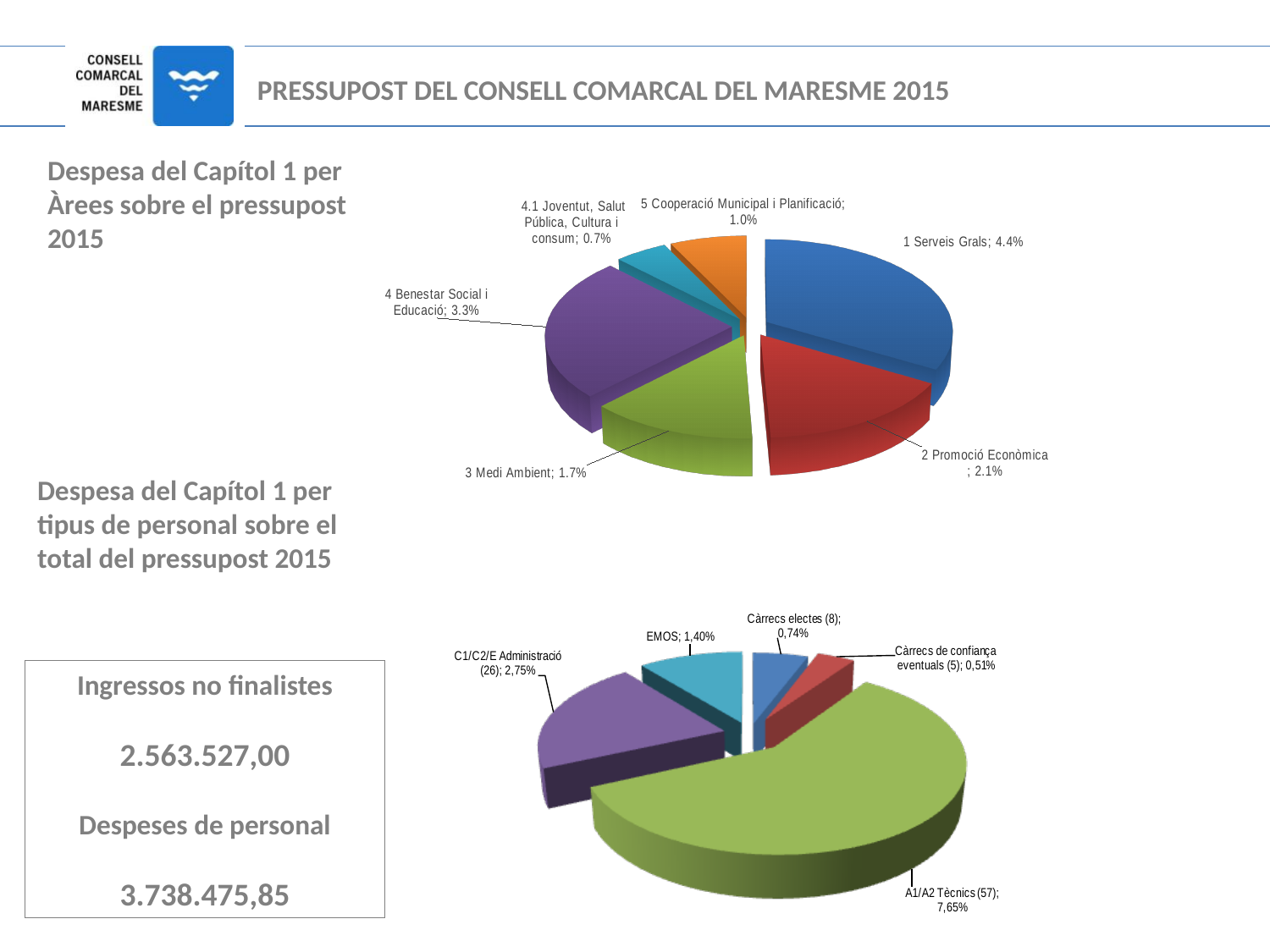
In the bottom pie chart (Despesa del Capítol 1 per tipus de personal), what is the value for A1/A2 Tècnics (57)? 7,65% In the top pie chart (Despesa del Capítol 1 per Àrees), which area has the smallest slice? 4.1 Joventut, Salut Pública, Cultura i consum In the top pie chart (Despesa del Capítol 1 per Àrees), which is larger: 5 Cooperació Municipal i Planificació or 3 Medi Ambient? 3 Medi Ambient In the bottom pie chart (Despesa del Capítol 1 per tipus de personal), which category has the smallest slice? Càrrecs de confiança eventuals (5) In the bottom pie chart (Despesa del Capítol 1 per tipus de personal), how many slices are there? 5 What type of chart is used for the bottom chart (Despesa del Capítol 1 per tipus de personal)? Pie chart In the bottom pie chart (Despesa del Capítol 1 per tipus de personal), what is the value for EMOS? 1,40% In the top pie chart (Despesa del Capítol 1 per Àrees), what is the difference between 2 Promoció Econòmica and 3 Medi Ambient? 0.4% In the top pie chart (Despesa del Capítol 1 per Àrees), which area has the largest slice? 1 Serveis Grals In the top pie chart (Despesa del Capítol 1 per Àrees), what is the value for 1 Serveis Grals? 4.4% In the top pie chart (Despesa del Capítol 1 per Àrees), how many slices are there? 6 In the top pie chart (Despesa del Capítol 1 per Àrees), what is the value for 4 Benestar Social i Educació? 3.3%